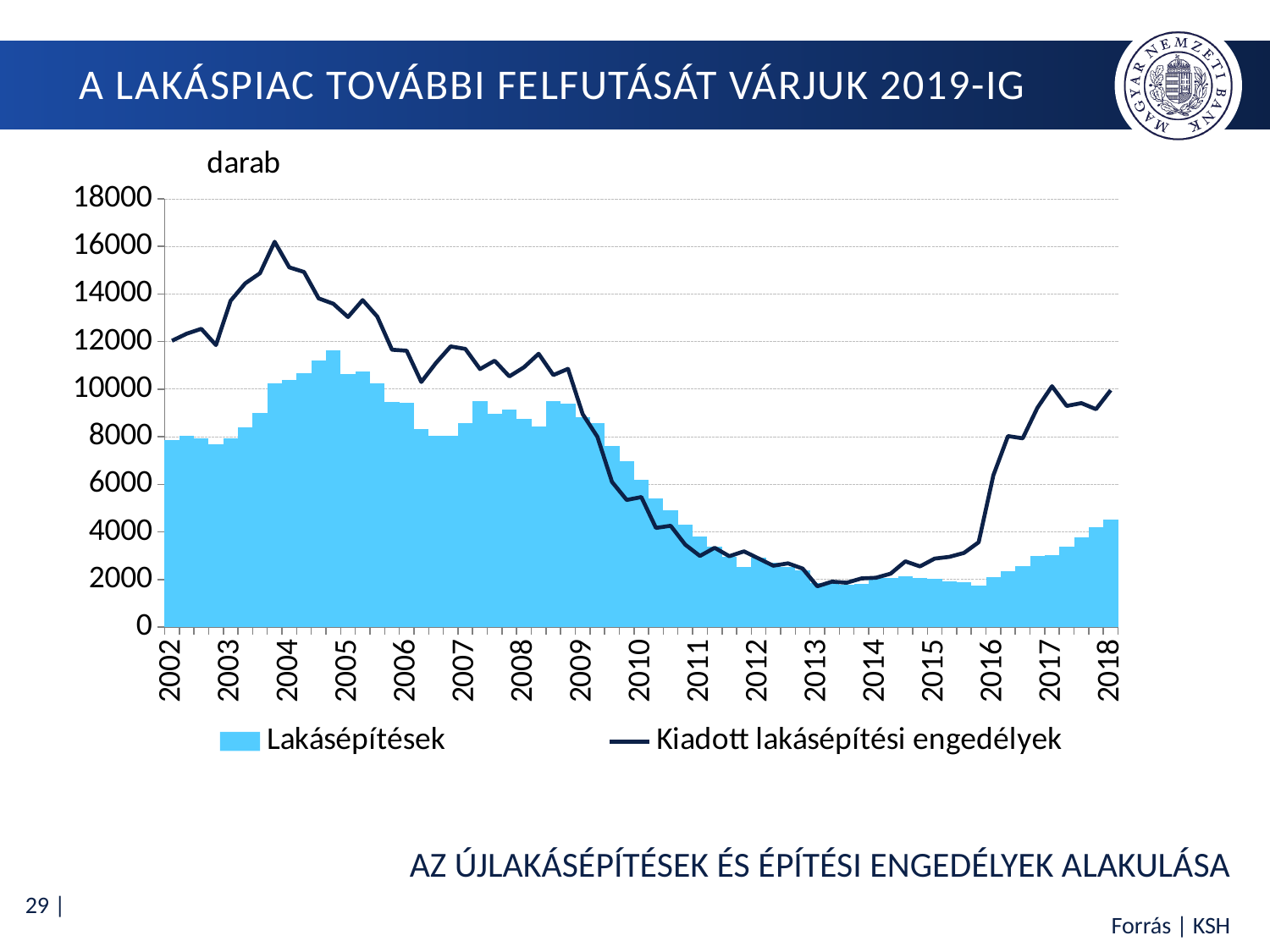
Is the value of Lakásépítések at 2013 greater or less than 4000? less What kind of chart is shown on the slide? A combined bar and line chart Is the value of Kiadott lakásépítési engedélyek at 2013 greater or less than 4000? less At 2017, which is higher: Lakásépítések or Kiadott lakásépítési engedélyek? Kiadott lakásépítési engedélyek What is the source cited for the chart? KSH How many series does the legend list? 2 What unit is shown above the vertical axis? darab Does the Kiadott lakásépítési engedélyek line rise or fall between 2009 and 2013? fall Is the value of Kiadott lakásépítési engedélyek at 2004 greater or less than 14000? greater How many year labels are shown on the x axis? 17